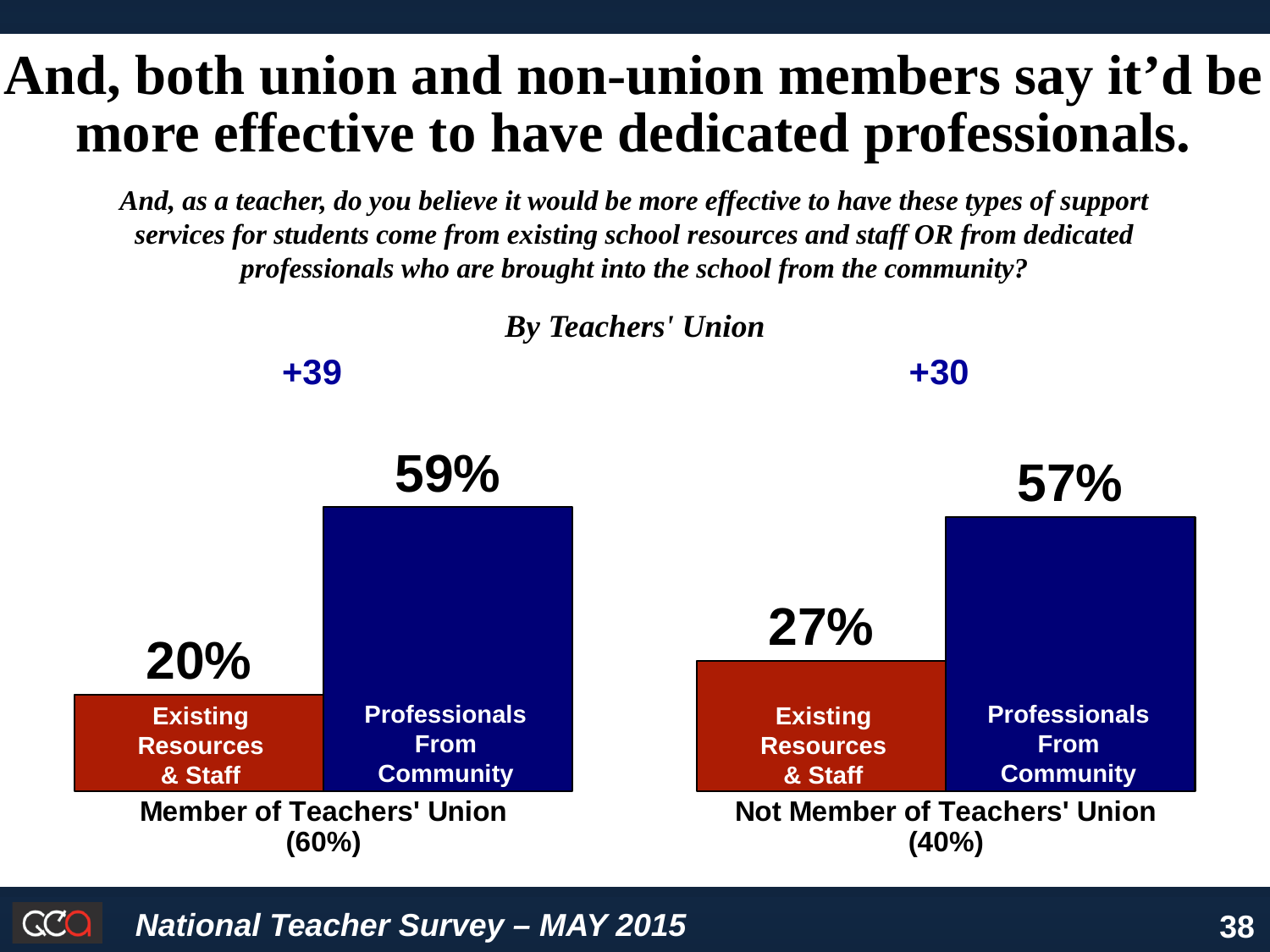
What percentage of non-members of the teachers' union say Existing Resources & Staff would be more effective? 27% What is the difference between Professionals From Community and Existing Resources & Staff among non-members of the teachers' union? 30 percentage points How many bars are plotted on the chart? 4 What percentage of non-members of the teachers' union say Professionals From Community would be more effective? 57% Which response has the highest value on the chart? Professionals From Community (Member of Teachers' Union) What percentage of members of the teachers' union say Existing Resources & Staff would be more effective? 20% What share of respondents are members of the teachers' union, as shown in the group label? 60% What is the difference between Professionals From Community and Existing Resources & Staff among members of the teachers' union? 39 percentage points Which is larger: Existing Resources & Staff among union members or Existing Resources & Staff among non-members? Non-members (27%) What type of chart is shown on the slide? Bar chart Which response has the lowest value on the chart? Existing Resources & Staff (Member of Teachers' Union) What percentage of members of the teachers' union say Professionals From Community would be more effective? 59%